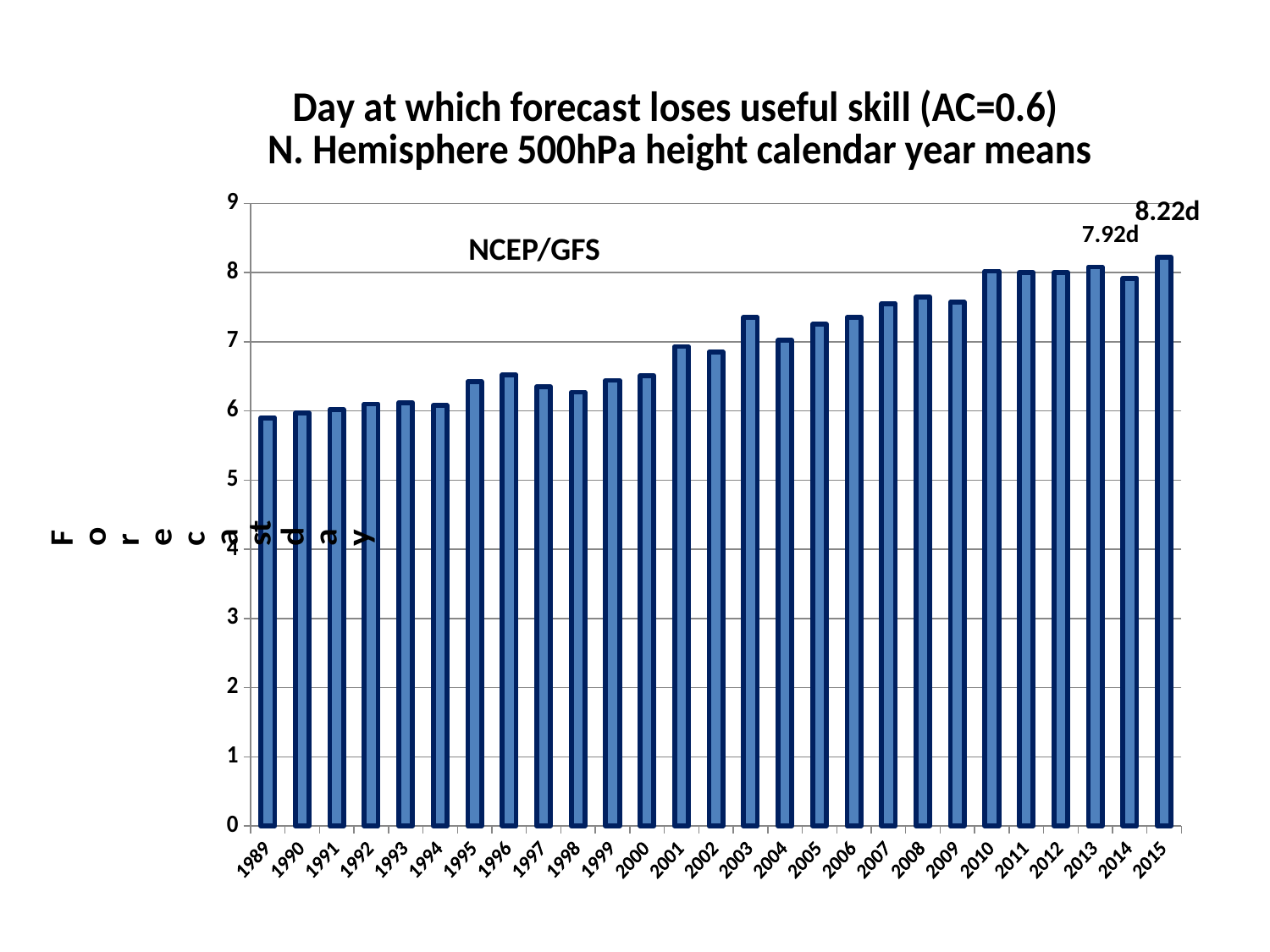
Do the values generally rise or fall from 1989 to 2015? rise What kind of chart is shown on the slide? bar chart What model name is written inside the plot area of the chart? NCEP/GFS What is the difference between the values for 2015 and 2014? 0.30d Is the value for 1989 greater or less than 6? less Which year has the highest value on the chart? 2015 How many years (bars) are plotted on the chart? 27 Is the value for 2003 greater or less than 7? greater What is the value shown for 2014? 7.92d What is the value shown for 2015? 8.22d Which is larger, the value for 2003 or the value for 2004? 2003 Is the value for 2000 greater or less than 7? less